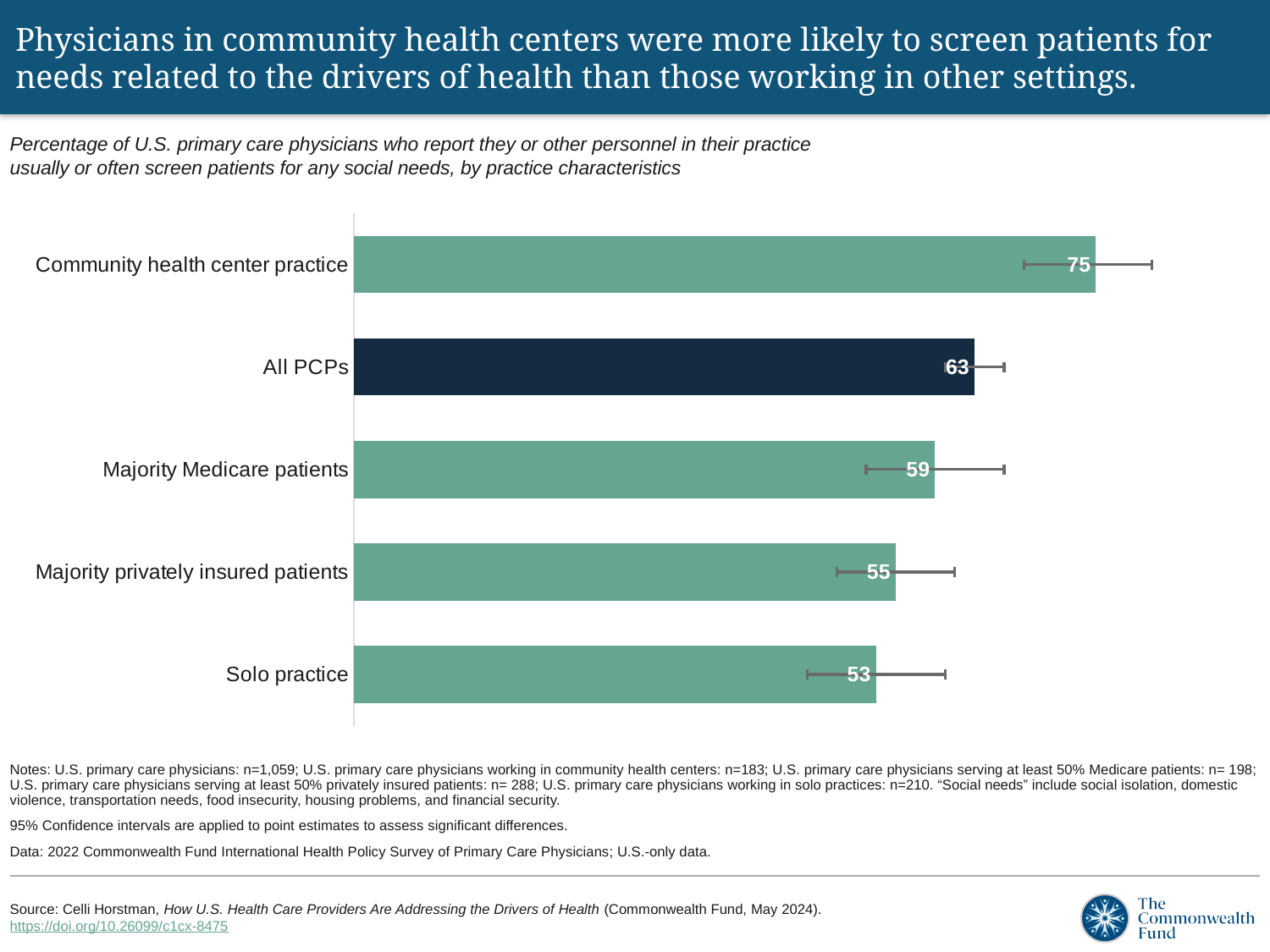
Which category has the highest value? Community health center practice Which category has the lowest value? Solo practice What is the value for All PCPs? 63 What is the value for Solo practice? 53 Which is larger, the value for Majority Medicare patients or the value for Majority privately insured patients? Majority Medicare patients Which bar is shown in a darker colour than the others? All PCPs What is the value for Community health center practice? 75 What is the difference between the values for Majority privately insured patients and Solo practice? 2 What kind of chart is shown on the slide? Bar chart What is the value for Majority Medicare patients? 59 How many categories are shown in the chart? 5 What is the difference between the values for Community health center practice and All PCPs? 12